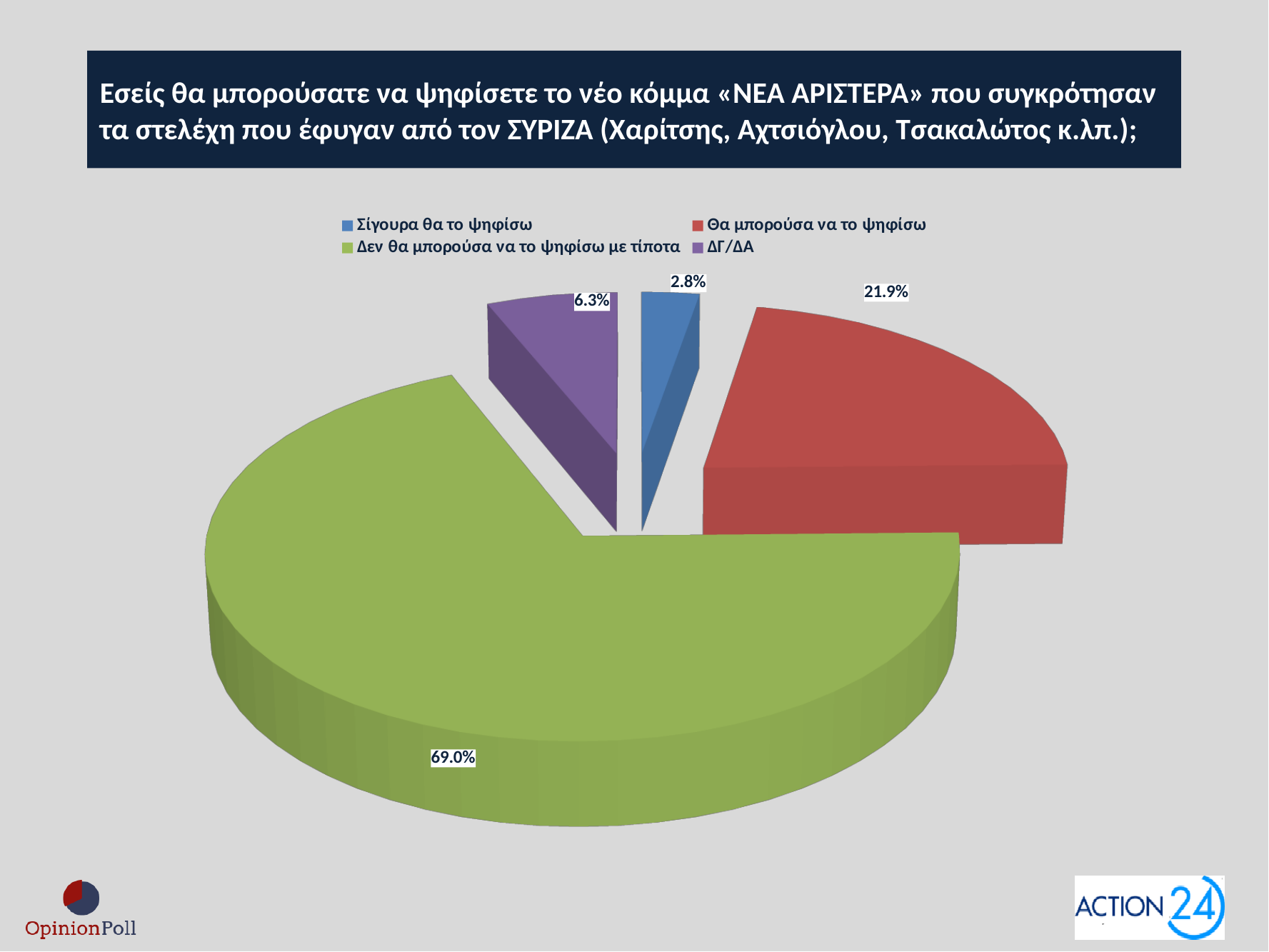
Which is larger: the share for «ΔΓ/ΔΑ» or the share for «Σίγουρα θα το ψηφίσω»? ΔΓ/ΔΑ How many slices does the pie chart have? 4 What kind of chart is shown on the slide? Pie chart Which response has the largest share of the pie? Δεν θα μπορούσα να το ψηφίσω με τίποτα What is the difference in percentage points between «Θα μπορούσα να το ψηφίσω» and «Σίγουρα θα το ψηφίσω»? 19.1 What percentage of respondents answered «ΔΓ/ΔΑ»? 6.3% What percentage of respondents answered «Δεν θα μπορούσα να το ψηφίσω με τίποτα»? 69.0% What colour is the slice for «Θα μπορούσα να το ψηφίσω»? Red How many entries does the legend list? 4 Which response has the smallest share of the pie? Σίγουρα θα το ψηφίσω What percentage of respondents answered «Θα μπορούσα να το ψηφίσω»? 21.9% What percentage of respondents answered «Σίγουρα θα το ψηφίσω»? 2.8%